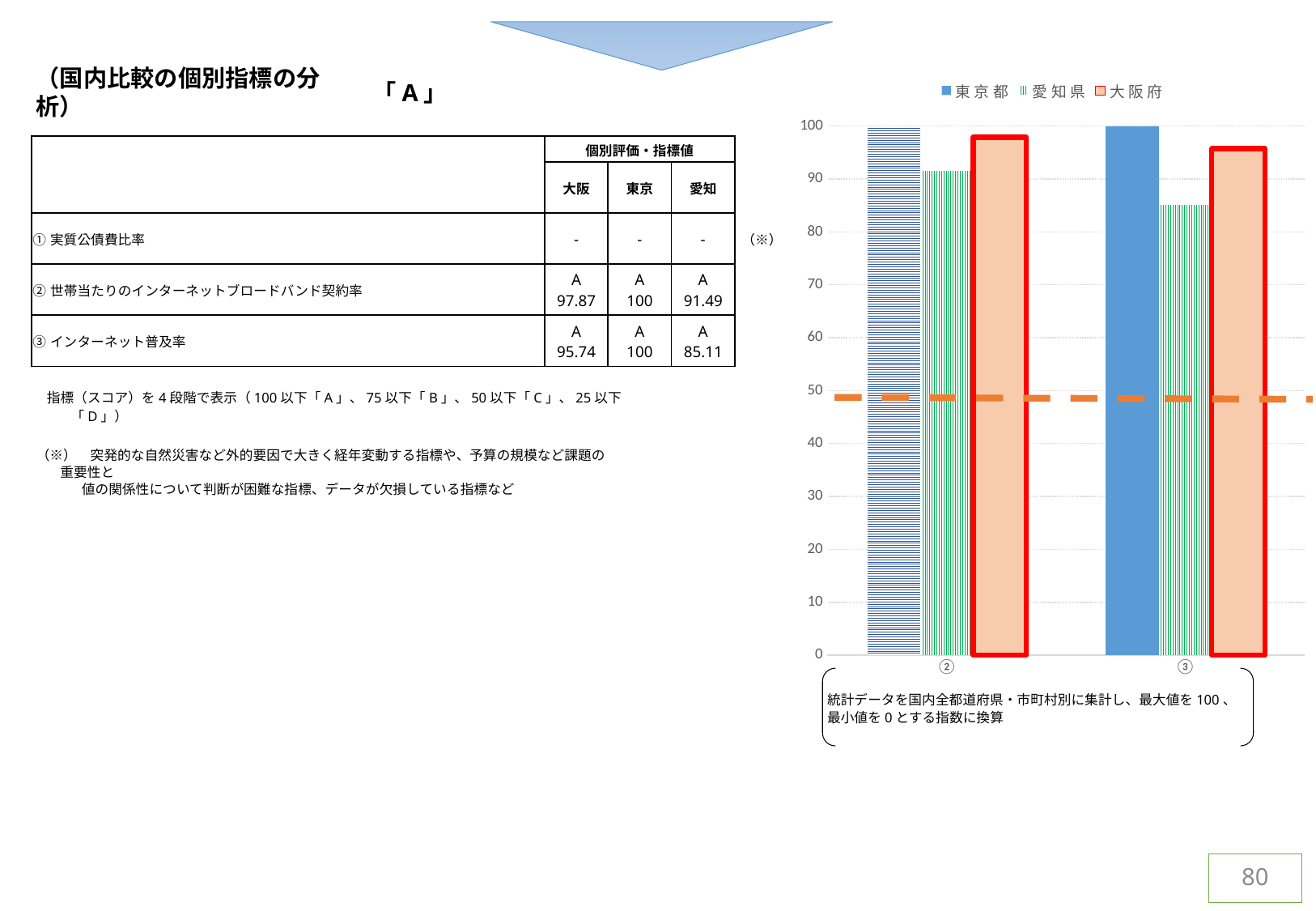
What kind of chart is shown on the right of the slide? bar chart Does the value for 愛知県 rise or fall from category ② to category ③? fall Which series has the lowest value in category ③? 愛知県 Which series has the highest value in category ②? 東京都 Is the value for 大阪府 in category ② greater or less than 90? greater What is the value for 東京都 in category ②? 100 How many categories are shown on the x axis of the chart? 2 What is the value for 東京都 in category ③? 100 Is the value for 愛知県 in category ③ greater or less than 90? less How many series does the chart legend list? 3 In category ③, which is larger, the value for 大阪府 or the value for 愛知県? 大阪府 Which series' bars are outlined in red on the chart? 大阪府